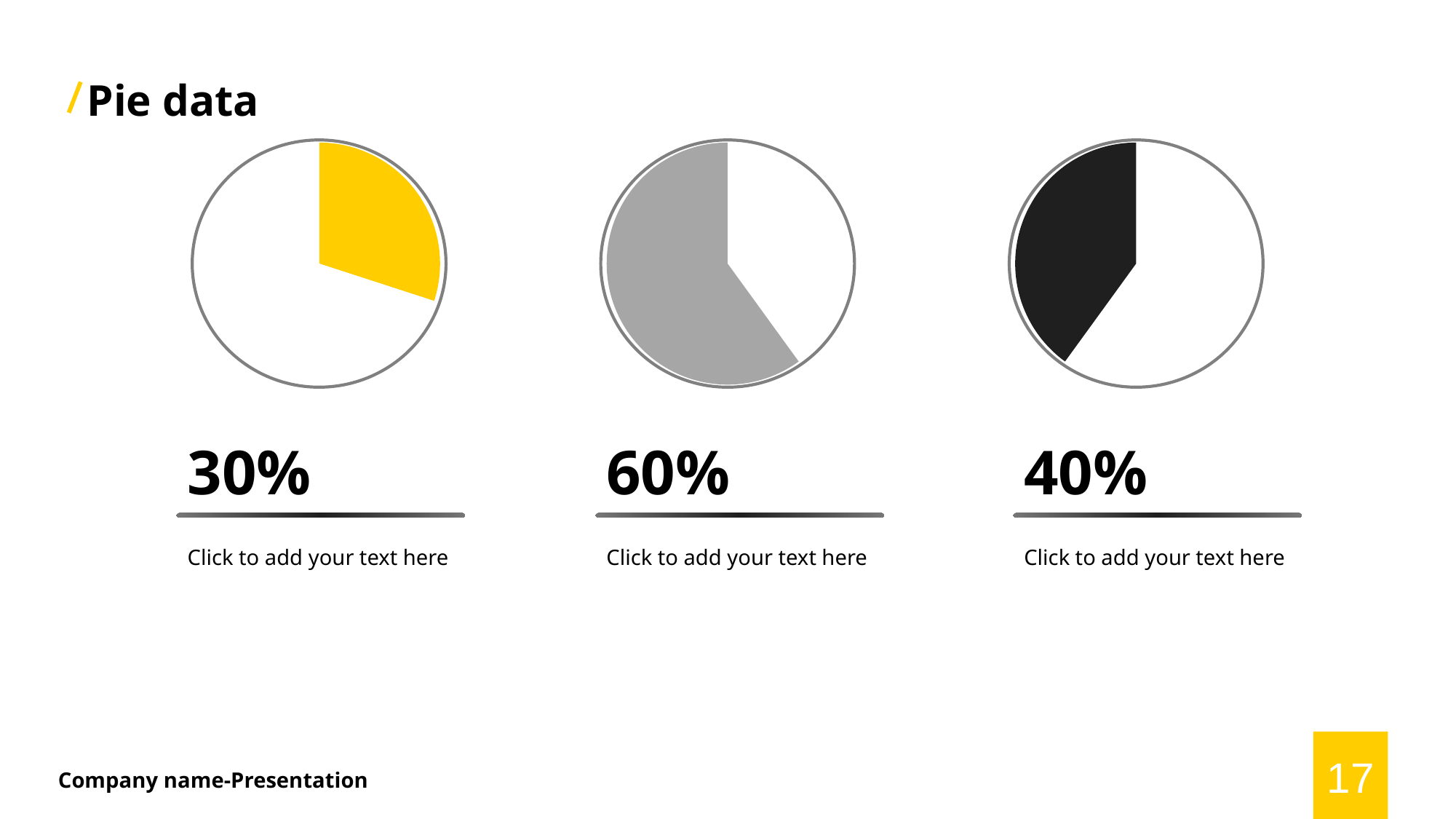
Which pie chart shows the smallest filled share: the left, middle or right one? left What kind of chart is shown on the left of the slide? pie chart What share does the black slice of the right pie chart represent? 40% Is the filled share of the right pie chart larger or smaller than the filled share of the left pie chart? larger What is the title of the slide containing the pie charts? Pie data Which pie chart shows the largest filled share: the left, middle or right one? middle What is the difference between the share shown under the middle pie chart and the share shown under the left pie chart? 30% What share does the grey slice of the middle pie chart represent? 60% How many pie charts are shown on the slide? 3 What is the difference between the share shown under the middle pie chart and the share shown under the right pie chart? 20% Is the filled share of the middle pie chart greater or less than 50%? greater What share does the yellow slice of the left pie chart represent? 30%